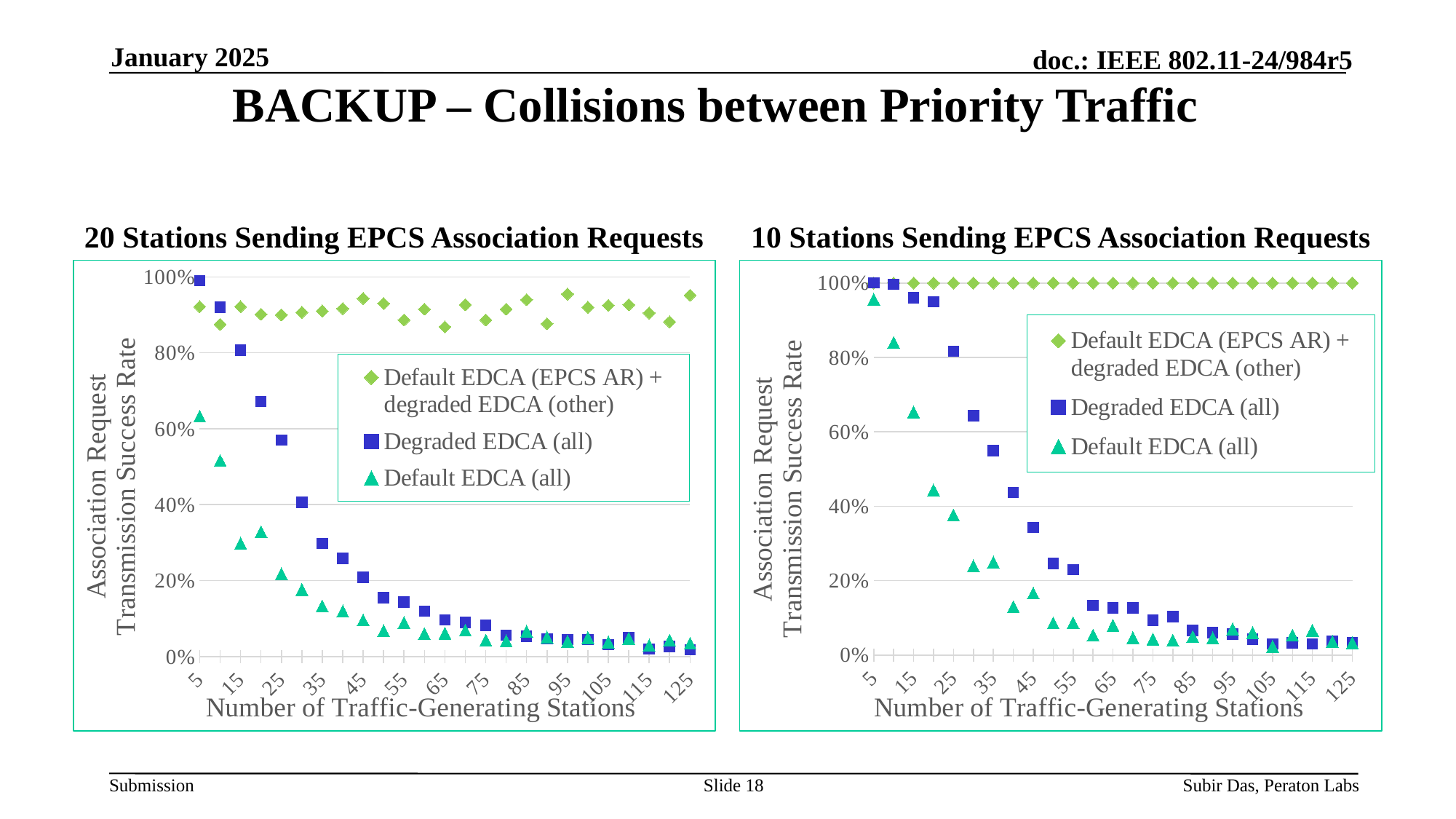
What is the y-axis label of the left chart (20 Stations)? Association Request Transmission Success Rate How many series does the legend list in the right chart, titled "10 Stations Sending EPCS Association Requests"? 3 In the right chart (10 Stations), is the value for Degraded EDCA (all) at 35 traffic-generating stations greater or less than 40%? greater How many data points does each series have in the right chart (10 Stations)? 25 What kind of chart is the left chart, titled "20 Stations Sending EPCS Association Requests"? scatter chart In the left chart (20 Stations), is the value for Degraded EDCA (all) at 55 traffic-generating stations greater or less than 20%? less In the right chart (10 Stations), which series stays at about 100% across all numbers of traffic-generating stations? Default EDCA (EPCS AR) + degraded EDCA (other) In the left chart (20 Stations), is the value for Degraded EDCA (all) at 5 traffic-generating stations greater or less than 80%? greater In the right chart (10 Stations), at 35 traffic-generating stations, which series has the larger value: Degraded EDCA (all) or Default EDCA (all)? Degraded EDCA (all) In the left chart (20 Stations), does the Degraded EDCA (all) series rise or fall as the number of traffic-generating stations increases? fall